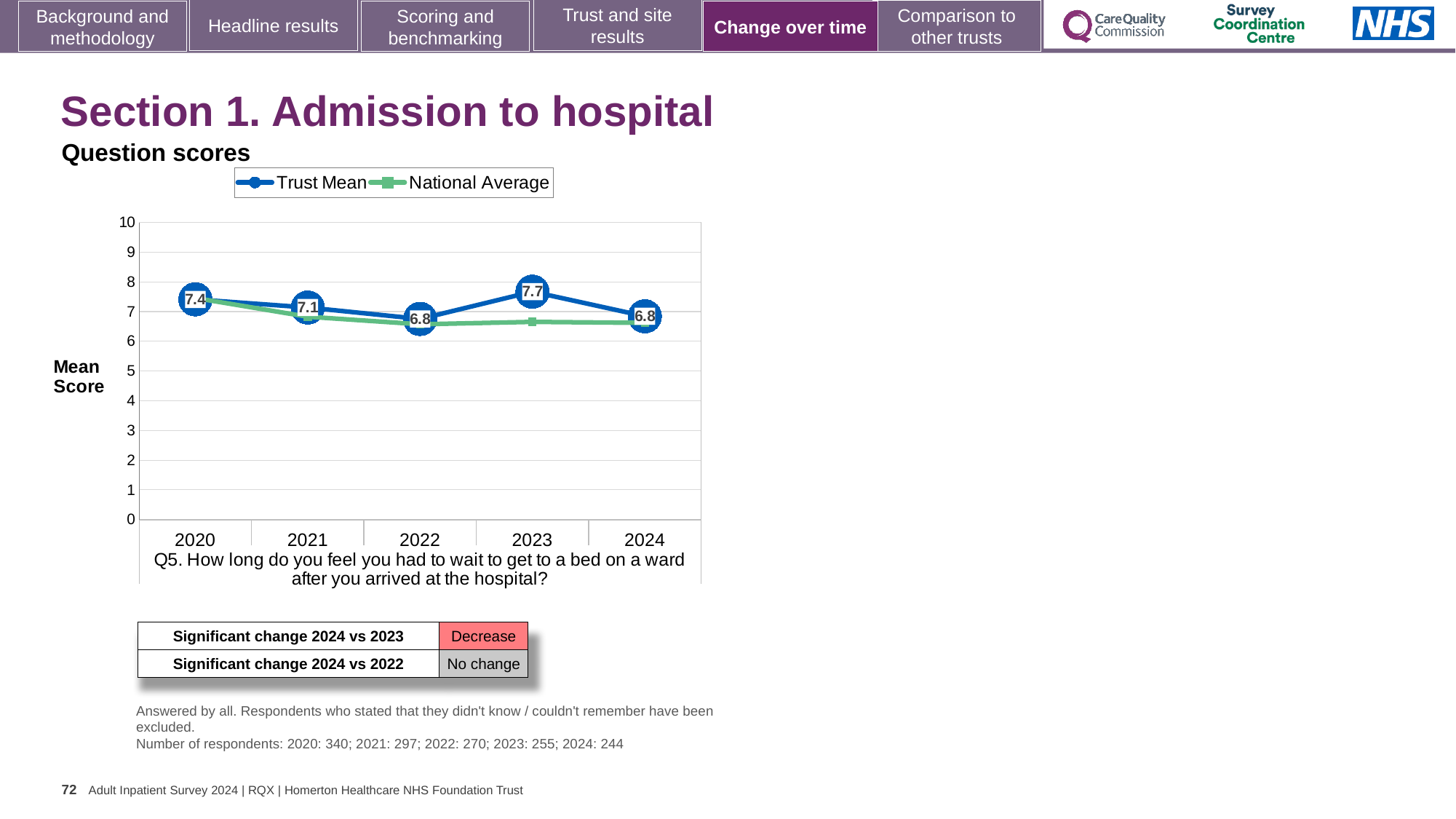
Is the National Average value for 2024 greater or less than 8? less What kind of chart is shown on the slide? line chart What is the label on the y axis of the chart? Mean Score How many series does the legend list? 2 What is the Trust Mean score for 2020? 7.4 In which year is the Trust Mean score highest? 2023 What is the difference between the Trust Mean scores for 2023 and 2024? 0.9 How many years are shown on the x axis? 5 What is the Trust Mean score for 2021? 7.1 Which is larger, the Trust Mean score for 2020 or for 2021? 2020 Does the Trust Mean score rise or fall from 2023 to 2024? fall What is the Trust Mean score for 2023? 7.7